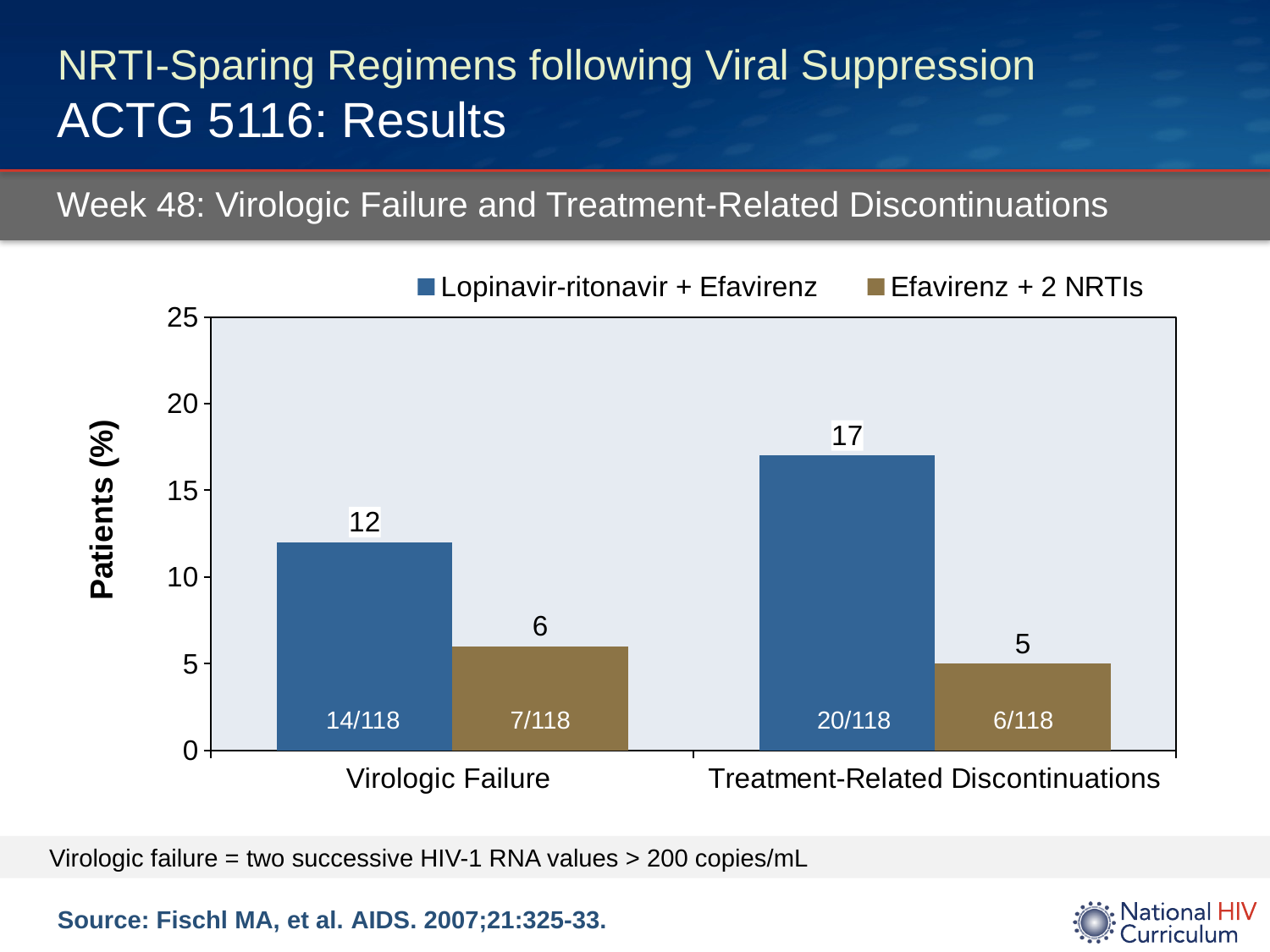
What fraction is printed on the Efavirenz + 2 NRTIs bar for Virologic Failure? 7/118 Which series has the larger value for Virologic Failure? Lopinavir-ritonavir + Efavirenz What is the value for Lopinavir-ritonavir + Efavirenz in the Virologic Failure category? 12 Which bar has the lowest value on the chart? Efavirenz + 2 NRTIs, Treatment-Related Discontinuations How many categories are shown on the x axis? 2 Is the value for Lopinavir-ritonavir + Efavirenz in Treatment-Related Discontinuations greater or less than 15? greater What is the difference between the two series in the Virologic Failure category? 6 What kind of chart is shown on the slide? Bar chart What is the difference between the two series in the Treatment-Related Discontinuations category? 12 How many series does the legend list? 2 What is the value for Efavirenz + 2 NRTIs in the Treatment-Related Discontinuations category? 5 Which bar has the highest value on the chart? Lopinavir-ritonavir + Efavirenz, Treatment-Related Discontinuations